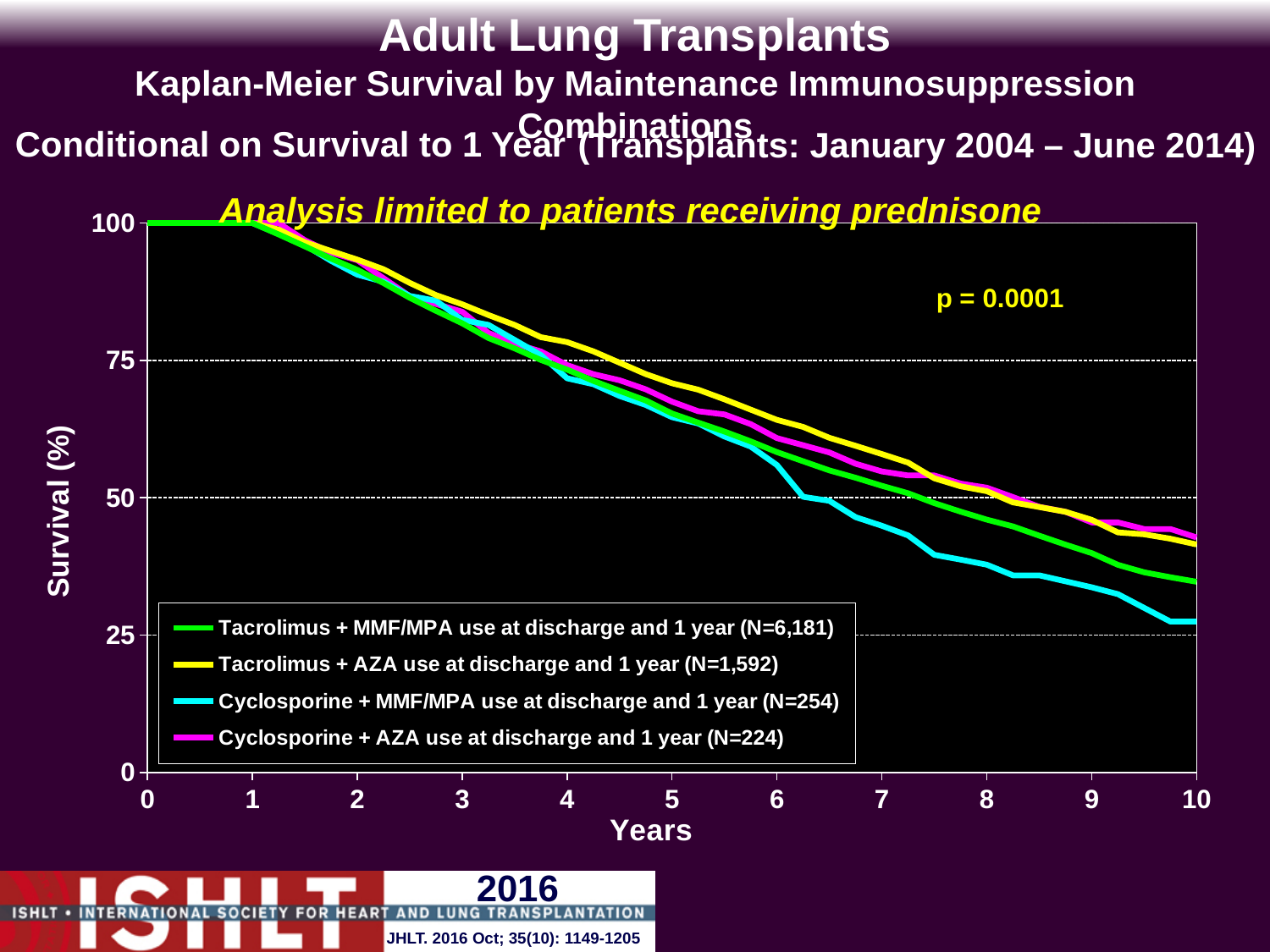
Is the survival value for Tacrolimus + MMF/MPA at 10 years greater or less than 50? less Is the survival value for Cyclosporine + AZA at 3 years greater or less than 75? greater Do the survival curves rise or fall as years increase? fall At 7 years, which series has higher survival: Tacrolimus + MMF/MPA or Cyclosporine + MMF/MPA? Tacrolimus + MMF/MPA What kind of chart is shown on the slide? line chart At 10 years, which series has higher survival: Tacrolimus + AZA or Cyclosporine + MMF/MPA? Tacrolimus + AZA Is the survival value for Cyclosporine + MMF/MPA at 10 years greater or less than 50? less What is the N for the Tacrolimus + MMF/MPA series in the legend? N=6,181 How many series does the legend list? 4 At 8 years, which series has the lowest survival? Cyclosporine + MMF/MPA use at discharge and 1 year What p-value is shown on the chart? p = 0.0001